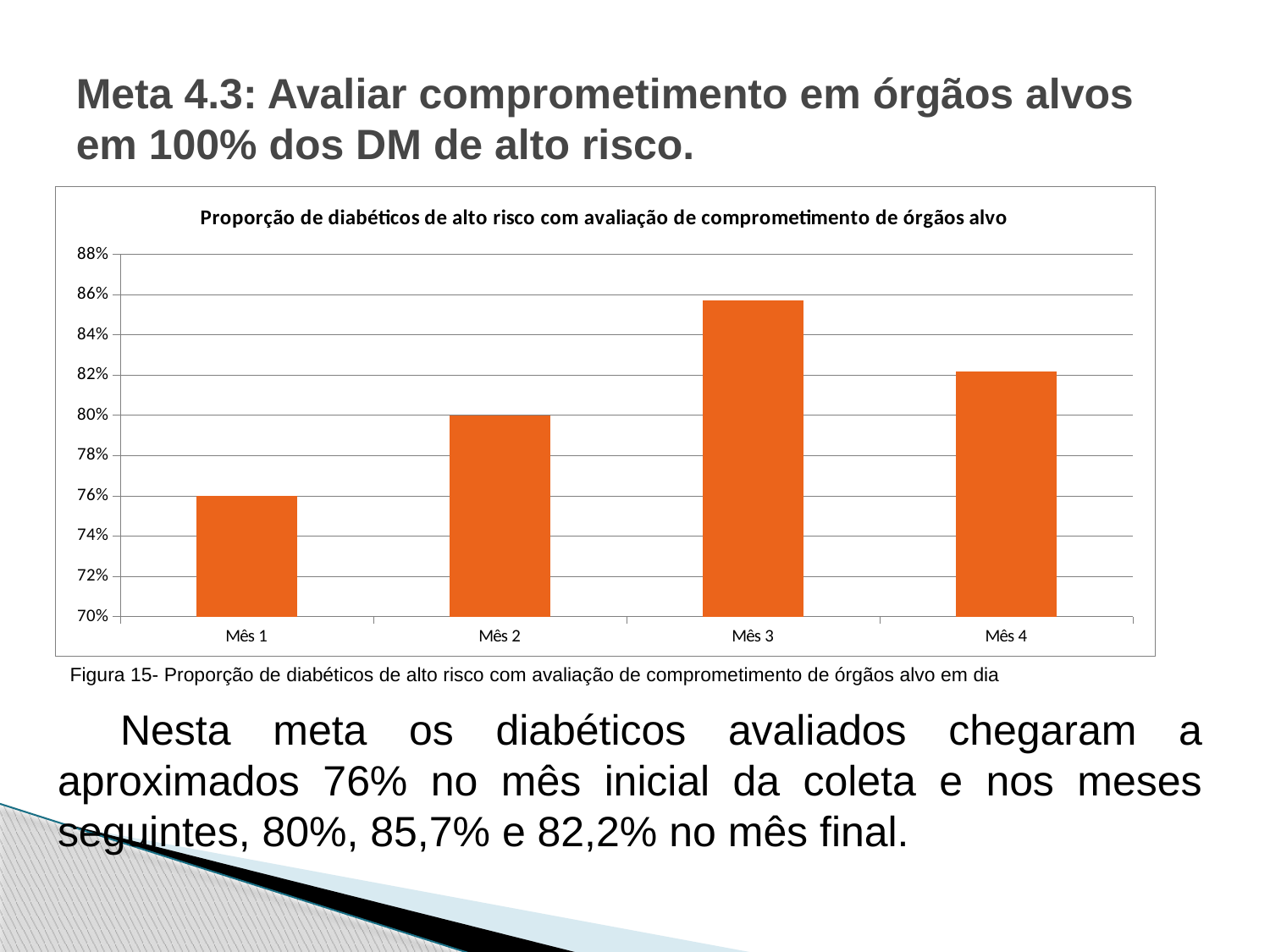
How many months (categories) are plotted in the chart? 4 Is the value for Mês 3 greater or less than 84%? greater Which month has the lowest value? Mês 1 What is the value for Mês 2? 80% What type of chart is shown on the slide? bar chart Is the value for Mês 4 greater or less than 84%? less What is the title of the chart? Proporção de diabéticos de alto risco com avaliação de comprometimento de órgãos alvo Which is larger, the value for Mês 2 or the value for Mês 4? Mês 4 Which month has the highest value? Mês 3 What is the difference between the values for Mês 2 and Mês 1? 4% What is the value for Mês 1? 76% What colour are the bars in the chart? orange